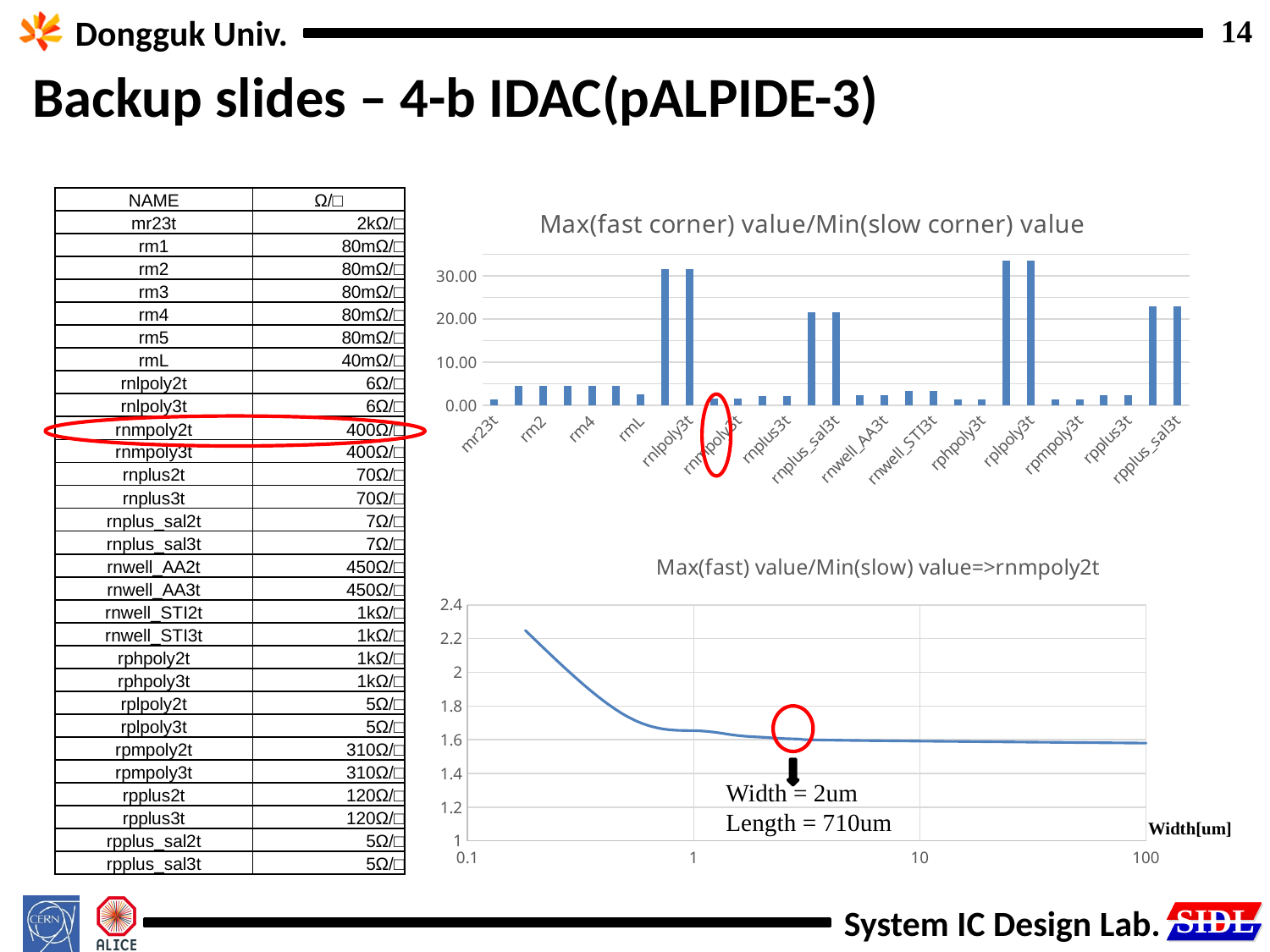
How many category labels are printed along the x axis of the bar chart 'Max(fast corner) value/Min(slow corner) value'? 15 In the bar chart 'Max(fast corner) value/Min(slow corner) value', which is larger, the value for rplpoly3t or the value for rnmpoly3t? rplpoly3t What is the x-axis label of the line chart 'Max(fast) value/Min(slow) value=>rnmpoly2t'? Width[um] In the bar chart 'Max(fast corner) value/Min(slow corner) value', which is larger, the value for rnlpoly3t or the value for rnwell_AA3t? rnlpoly3t In the line chart 'Max(fast) value/Min(slow) value=>rnmpoly2t', do the values rise or fall as width increases along the x axis? fall What kind of chart is the chart titled 'Max(fast corner) value/Min(slow corner) value'? bar chart In the bar chart 'Max(fast corner) value/Min(slow corner) value', is the value for rnmpoly3t greater or less than 10.00? less In the bar chart 'Max(fast corner) value/Min(slow corner) value', is the value for rpplus_sal3t greater or less than 20.00? greater What kind of chart is the chart titled 'Max(fast) value/Min(slow) value=>rnmpoly2t'? line chart In the bar chart 'Max(fast corner) value/Min(slow corner) value', is the value for rplpoly3t greater or less than 30.00? greater